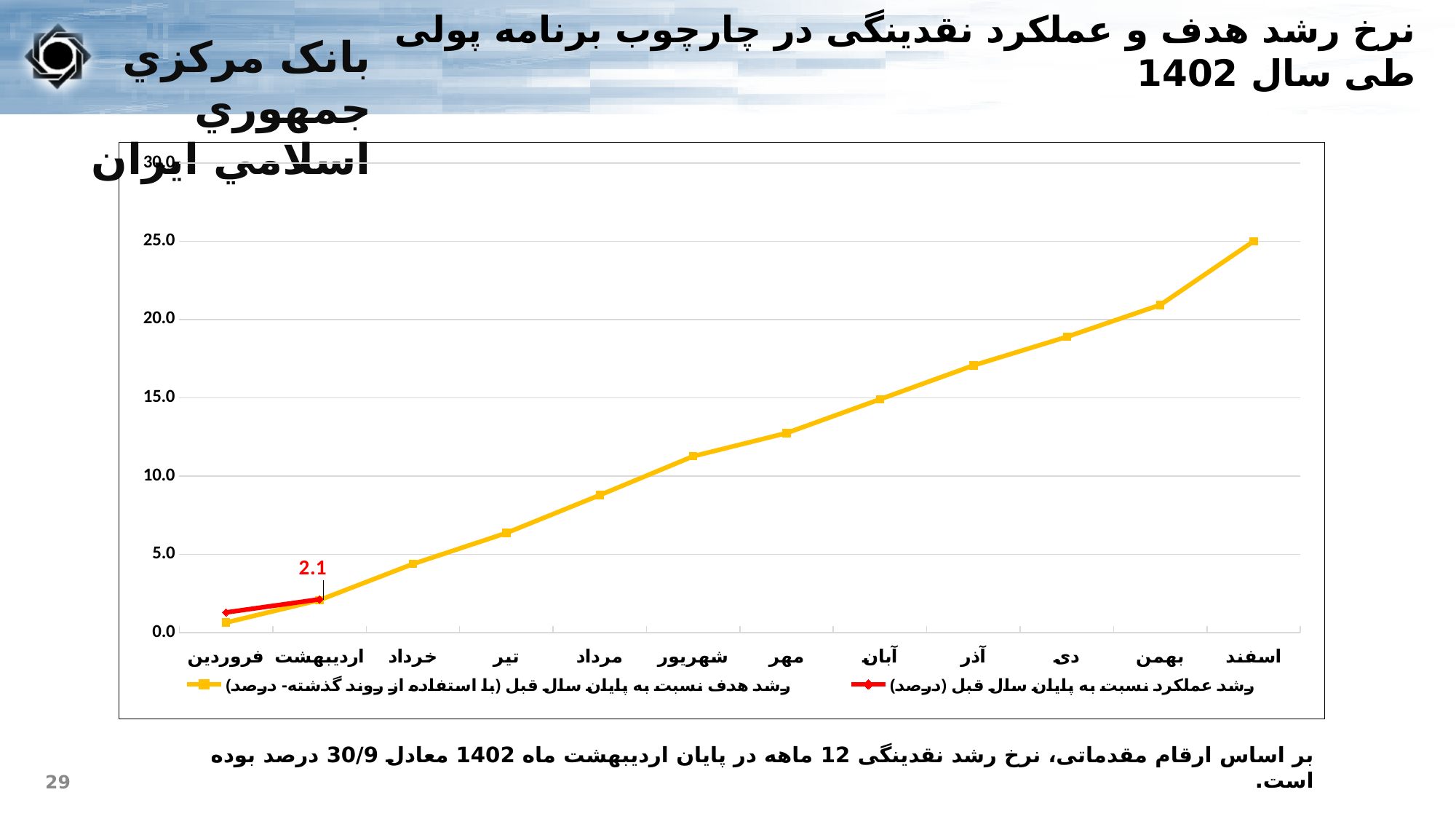
Is the value of the yellow series (رشد هدف) at اسفند greater or less than 20.0? greater What is the labelled value of the red series (رشد عملکرد) at اردیبهشت? 2.1 What kind of chart is shown on the slide? Line chart Do the values of the yellow series (رشد هدف) rise or fall from فروردین to اسفند? rise Which month has the larger value for the yellow series (رشد هدف): بهمن or آذر? بهمن Is the value of the yellow series (رشد هدف) at مهر greater or less than 10.0? greater Is the value of the yellow series (رشد هدف) at تیر greater or less than 10.0? less In which month does the yellow series (رشد هدف) reach its highest value? اسفند In which month does the yellow series (رشد هدف) have its lowest value? فروردین How many series does the chart legend list? 2 How many months are shown along the x axis of the chart? 12